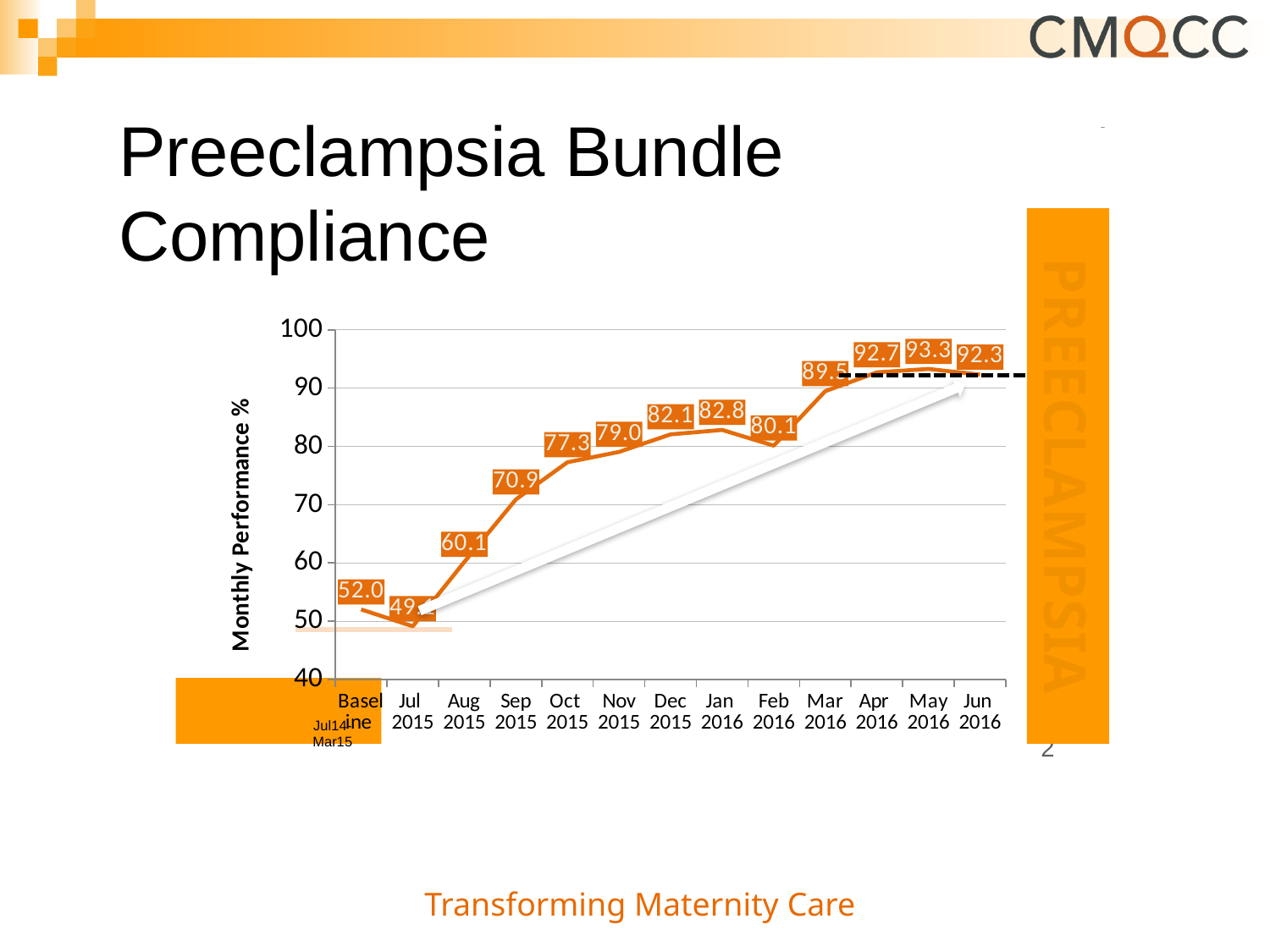
What is the difference between the Mar 2016 value and the Feb 2016 value? 9.4 What kind of chart is shown on the slide? line chart What is the value for Mar 2016? 89.5 What is the value for the Baseline period? 52.0 Which is larger, the value for Jan 2016 or the value for Feb 2016? Jan 2016 What is the difference between the Jun 2016 value and the Baseline value? 40.3 What is the value for Jun 2016? 92.3 Is the value for Jul 2015 greater or less than 60? less Which point on the chart has the lowest value? Jul 2015 What is the value for Aug 2015? 60.1 Which month has the highest value? May 2016 What is the label on the vertical axis? Monthly Performance %